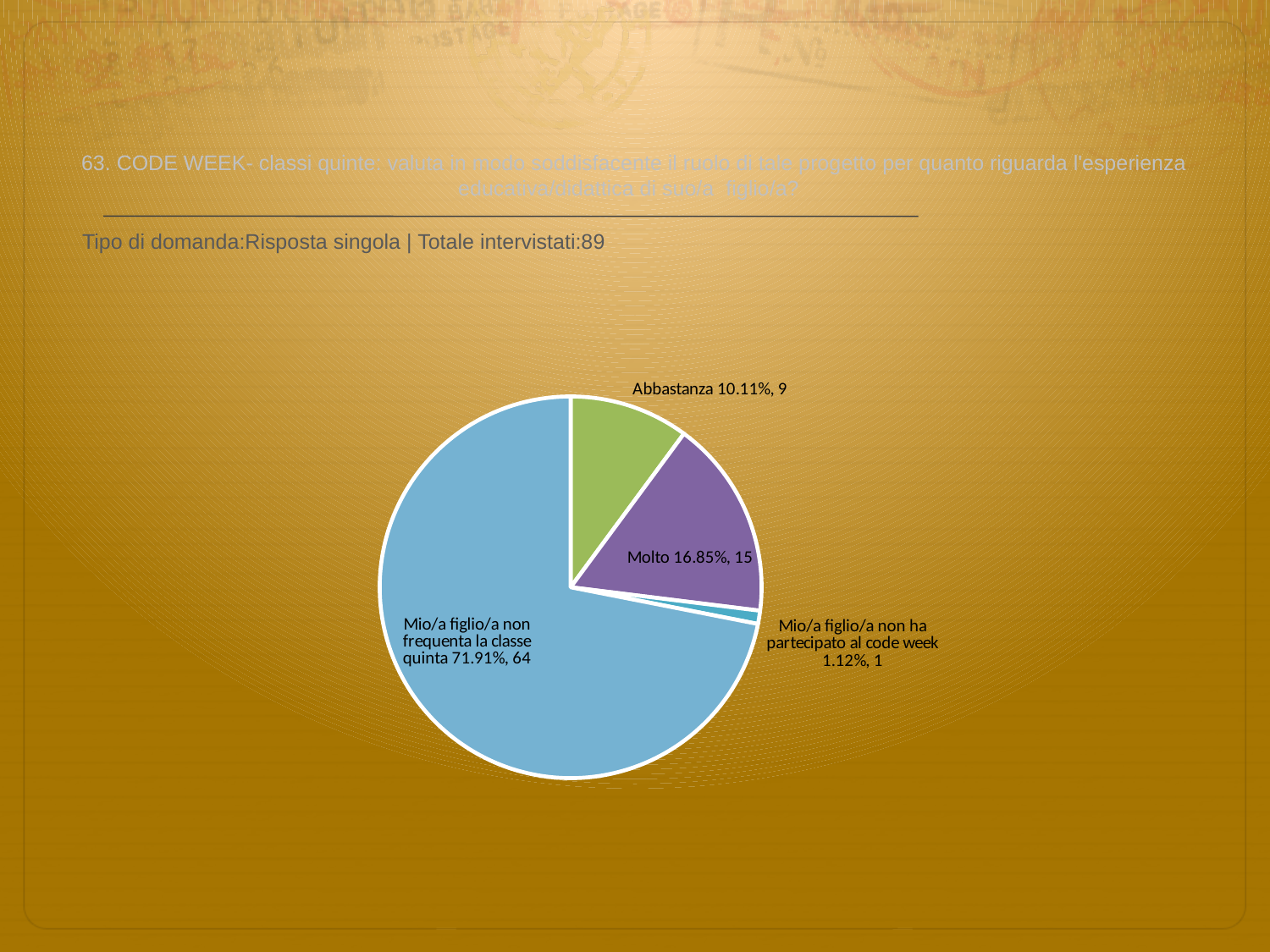
What is the difference in respondent count between 'Molto' and 'Abbastanza'? 6 How many respondents answered 'Abbastanza'? 9 What percentage of the pie is the 'Molto' slice? 16.85% What kind of chart is shown on the slide? Pie chart Which has more respondents, 'Molto' or 'Abbastanza'? Molto How many respondents answered 'Mio/a figlio/a non frequenta la classe quinta'? 64 How many slices does the pie chart have? 4 What is the total number of respondents (Totale intervistati) stated on the slide? 89 Which category has the smallest slice of the pie? Mio/a figlio/a non ha partecipato al code week Which category has the largest slice of the pie? Mio/a figlio/a non frequenta la classe quinta What percentage of the pie is the 'Abbastanza' slice? 10.11% What percentage of the pie is the 'Mio/a figlio/a non ha partecipato al code week' slice? 1.12%